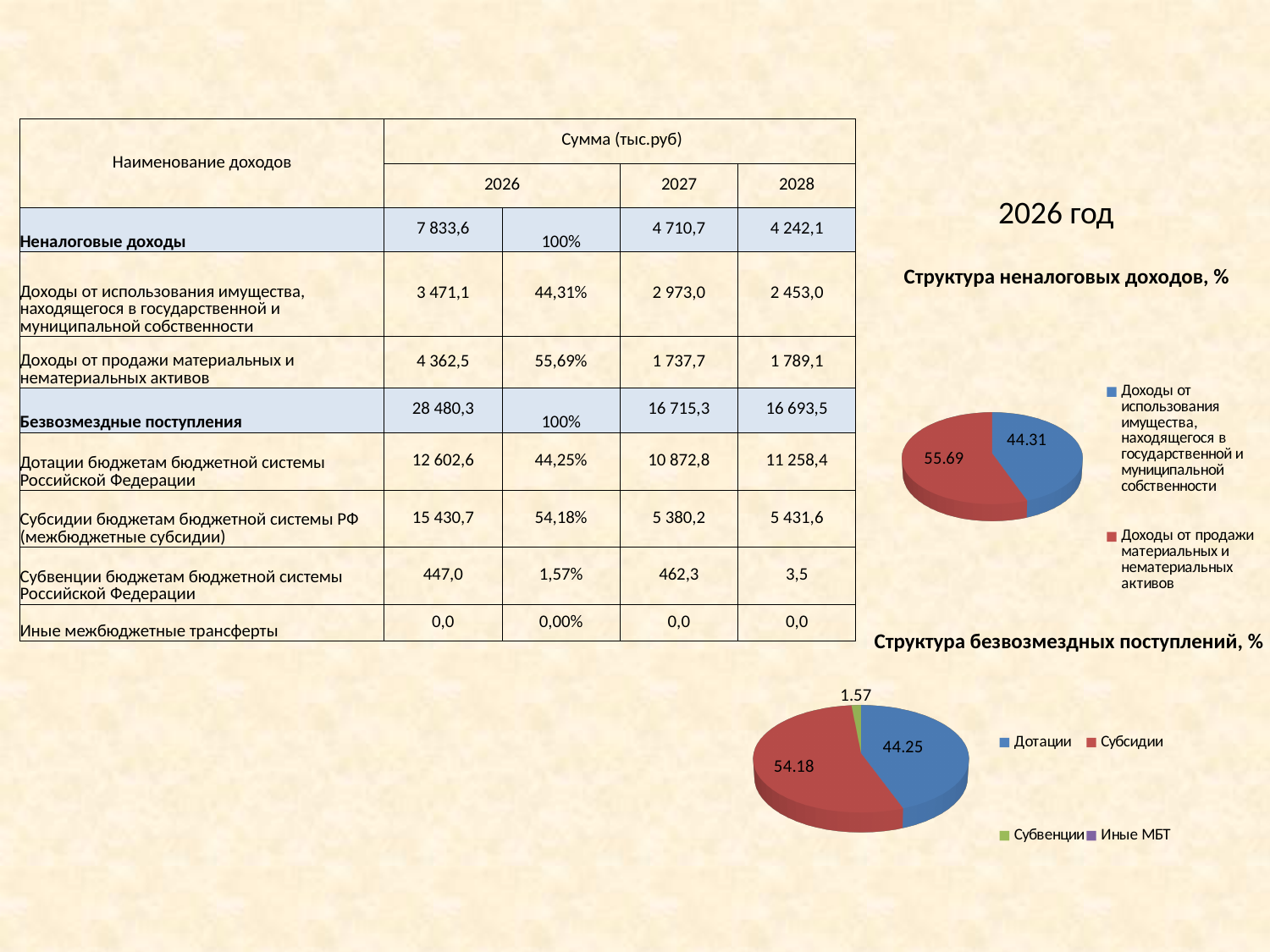
In the chart titled "Структура безвозмездных поступлений, %", which is larger, "Дотации" or "Субсидии"? Субсидии In the chart titled "Структура неналоговых доходов, %", what is the difference between the two slice values? 11.38 In the chart titled "Структура неналоговых доходов, %", which category has the larger slice? Доходы от продажи материальных и нематериальных активов In the chart titled "Структура неналоговых доходов, %", what value is shown for "Доходы от использования имущества, находящегося в государственной и муниципальной собственности"? 44.31 In the chart titled "Структура неналоговых доходов, %", what value is shown for "Доходы от продажи материальных и нематериальных активов"? 55.69 In the chart titled "Структура безвозмездных поступлений, %", which category has the largest slice? Субсидии In the chart titled "Структура безвозмездных поступлений, %", what value is shown for "Субвенции"? 1.57 How many entries does the legend of the chart "Структура безвозмездных поступлений, %" list? 4 In the chart titled "Структура безвозмездных поступлений, %", what value is shown for "Дотации"? 44.25 How many entries does the legend of the chart "Структура неналоговых доходов, %" list? 2 In the chart titled "Структура безвозмездных поступлений, %", what value is shown for "Субсидии"? 54.18 What type of chart is "Структура неналоговых доходов, %"? pie chart